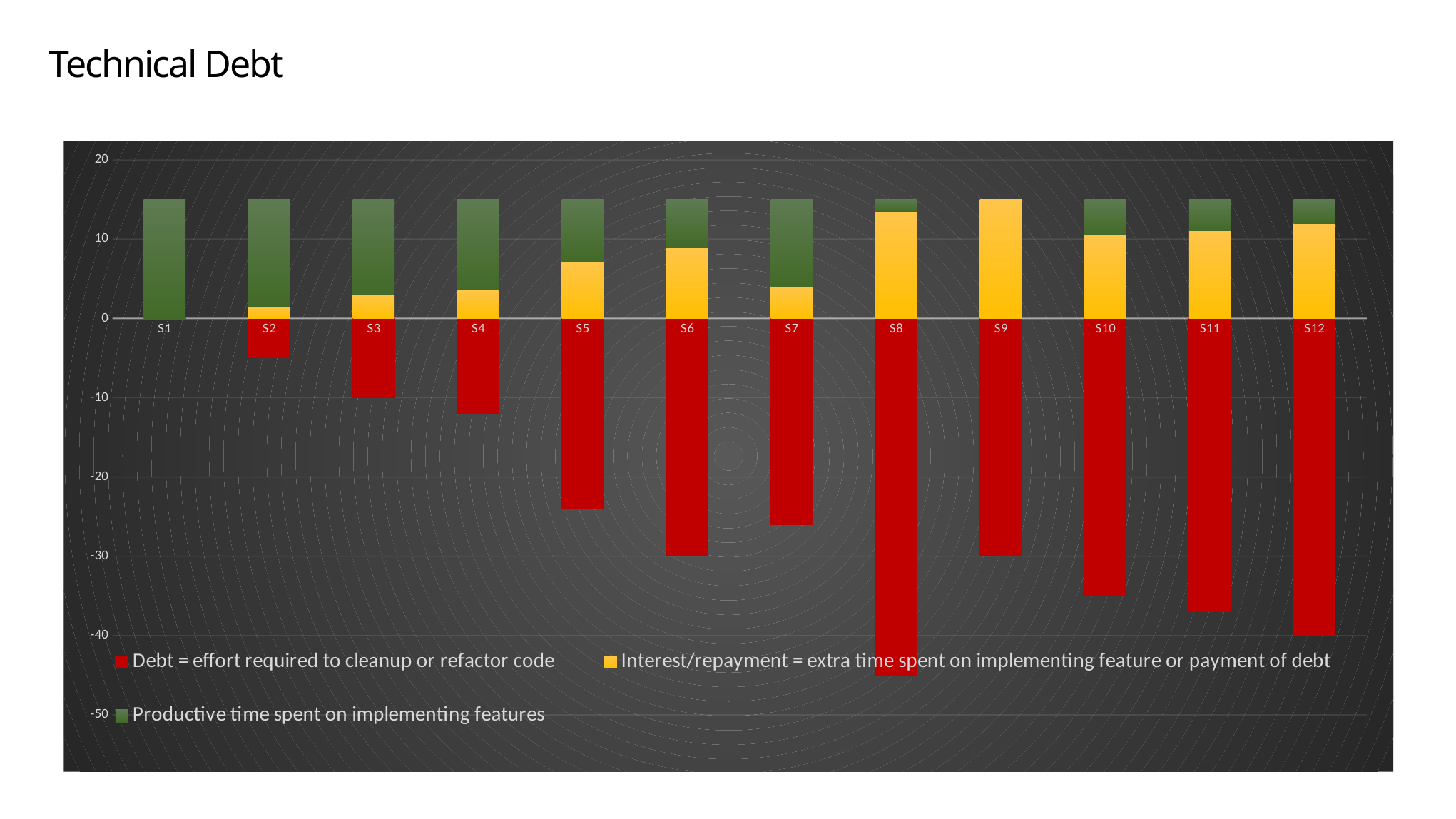
What is the title of the slide? Technical Debt Which sprint has the longer red debt bar, S5 or S6? S6 How many sprints (categories) are shown on the x axis? 12 Is the debt value for S5 greater or less than -30? greater Which sprint has the largest debt (longest red bar)? S8 How many series does the legend list? 3 Which colour represents 'Productive time spent on implementing features' in the legend? Green Do the red debt bars generally get longer or shorter from S1 to S12? Longer Is the debt value for S8 greater or less than -40? less What kind of chart is shown on the slide? Stacked bar chart Which sprint has the longer red debt bar, S3 or S4? S4 Which sprint has no debt bar at all? S1